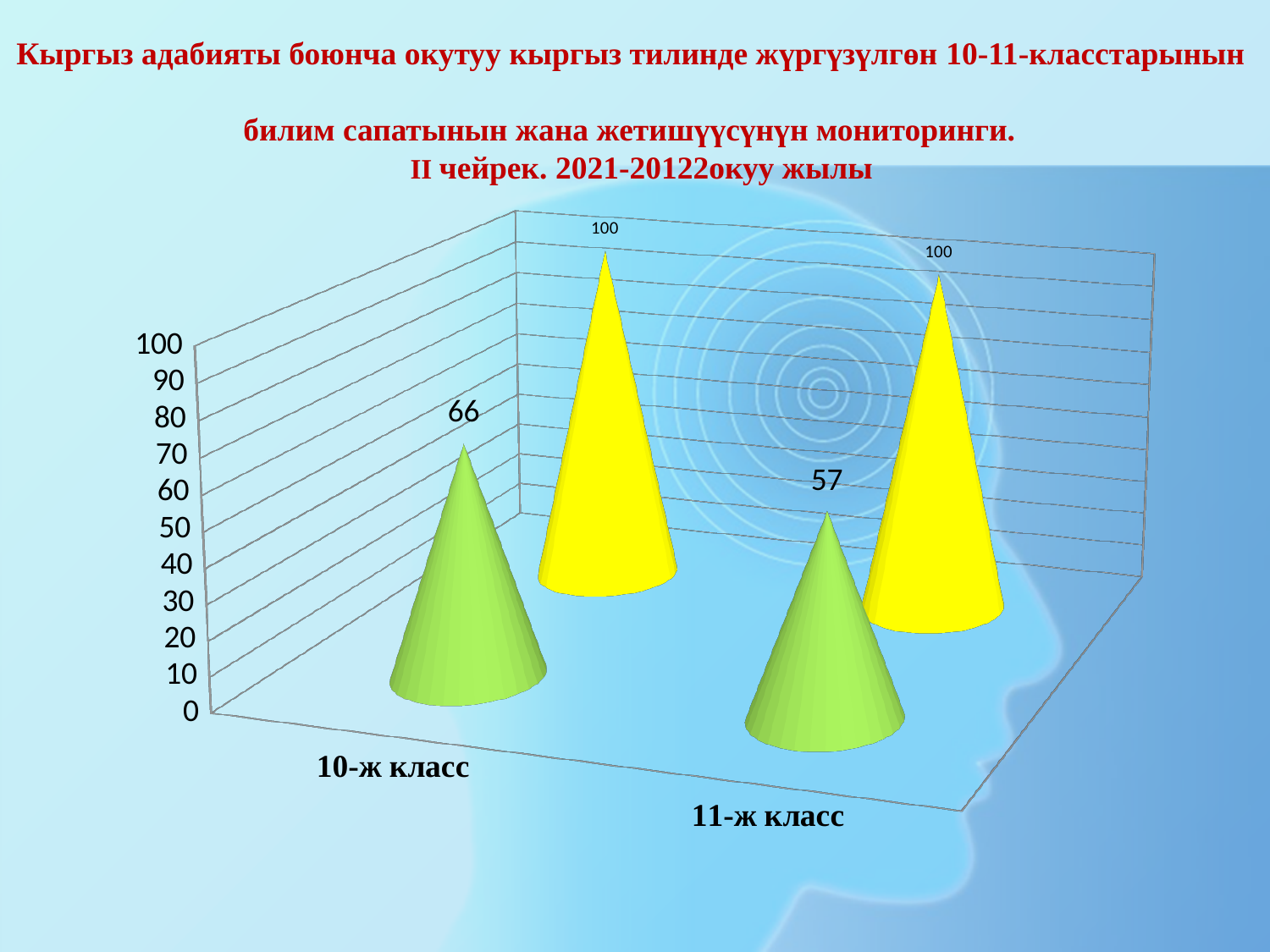
What is the difference between the green values for 10-ж класс and 11-ж класс? 9 What is the value of the green cone for 11-ж класс? 57 How many classes (categories) are shown on the x axis? 2 Which class has the larger green value, 10-ж класс or 11-ж класс? 10-ж класс For 10-ж класс, how much higher is the yellow value than the green value? 34 What colour are the cones that reach 100? Yellow What is the value of the yellow cone for 10-ж класс? 100 For 11-ж класс, how much higher is the yellow value than the green value? 43 Is the green value for 11-ж класс greater or less than 60? less Which class has the lowest green value? 11-ж класс What is the value of the green cone for 10-ж класс? 66 What is the value of the yellow cone for 11-ж класс? 100